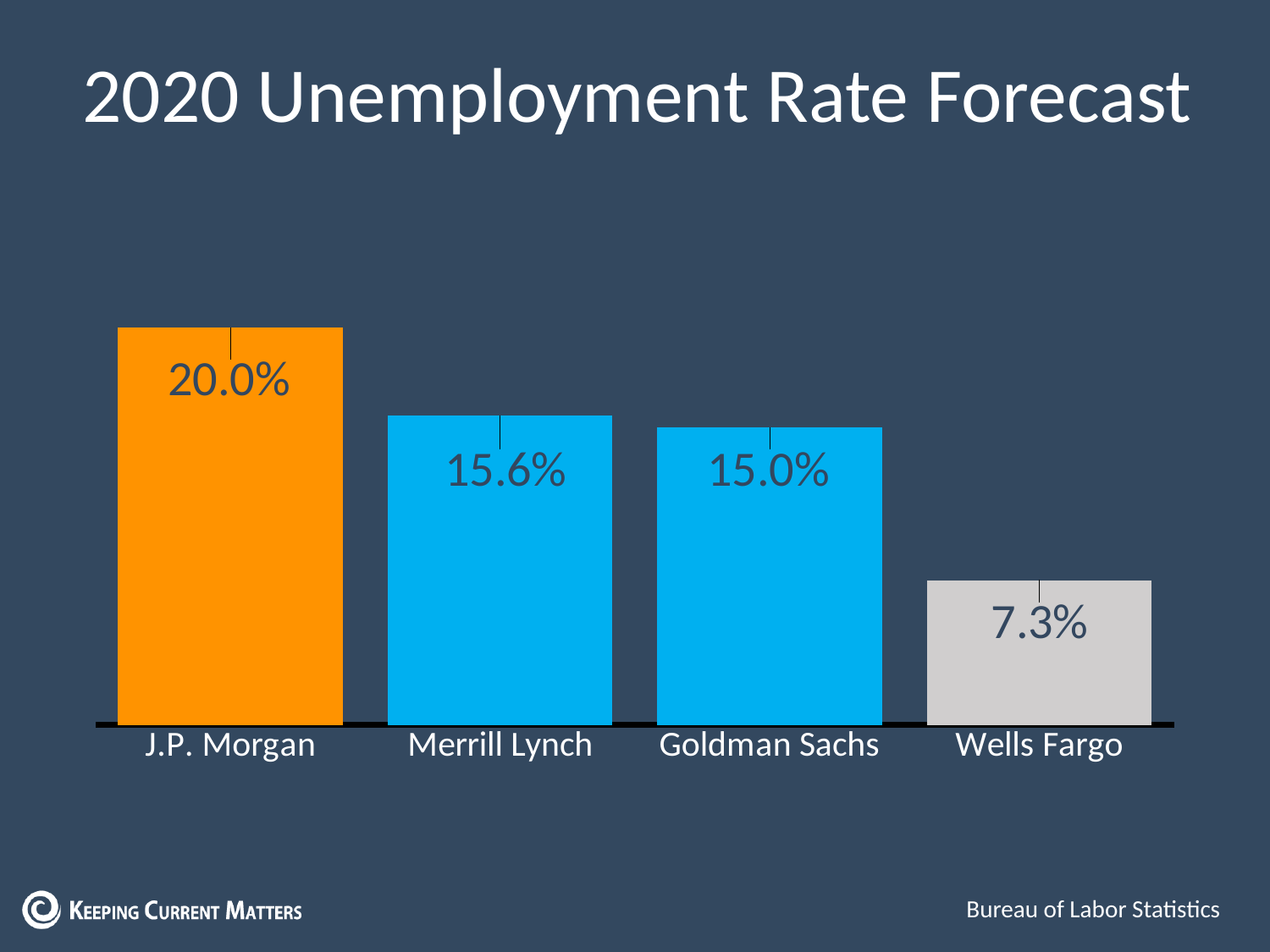
What is the 2020 unemployment rate forecast from Goldman Sachs? 15.0% What is the difference between the J.P. Morgan and Wells Fargo forecasts? 12.7% How many institutions are shown in the chart? 4 What is the title of the chart? 2020 Unemployment Rate Forecast Which institution has the lowest 2020 unemployment rate forecast? Wells Fargo What is the 2020 unemployment rate forecast from Wells Fargo? 7.3% What is the 2020 unemployment rate forecast from J.P. Morgan? 20.0% What is the 2020 unemployment rate forecast from Merrill Lynch? 15.6% What is the difference between the Merrill Lynch and Goldman Sachs forecasts? 0.6% Which institution has the highest 2020 unemployment rate forecast? J.P. Morgan Which forecast is larger, Merrill Lynch's or Goldman Sachs's? Merrill Lynch What kind of chart is shown on the slide? Bar chart